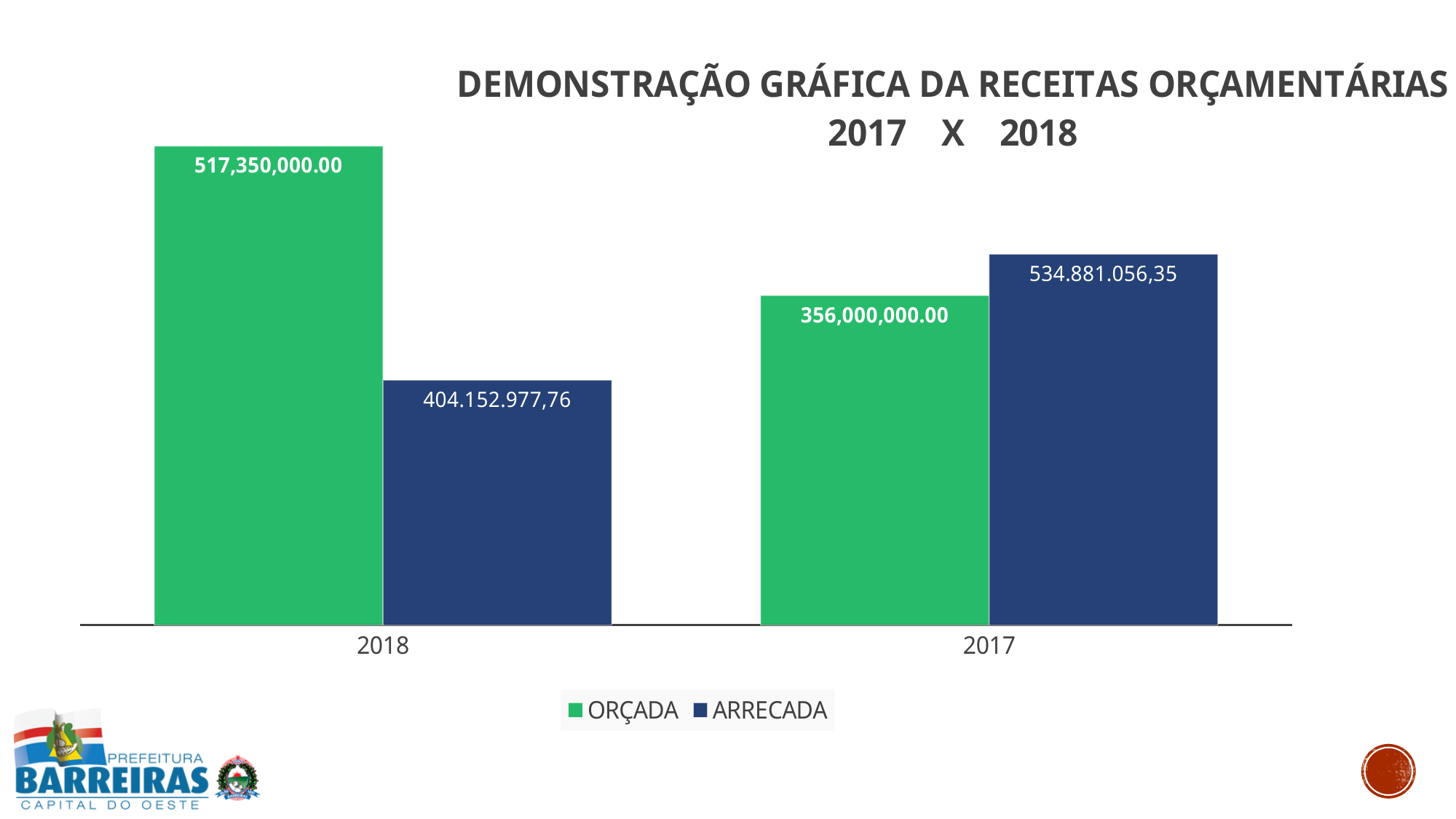
How many year categories are shown on the x axis? 2 How many series does the legend list? 2 What kind of chart is shown on the slide? Bar chart What is the ORÇADA value for 2018? 517,350,000.00 Which colour represents the ARRECADA series? Dark blue What is the ORÇADA value for 2017? 356,000,000.00 What is the title of the chart? DEMONSTRAÇÃO GRÁFICA DA RECEITAS ORÇAMENTÁRIAS 2017 X 2018 For 2017, which is larger, ORÇADA or ARRECADA? ARRECADA What is the ARRECADA value for 2018? 404.152.977,76 For 2018, which is larger, ORÇADA or ARRECADA? ORÇADA What is the ARRECADA value for 2017? 534.881.056,35